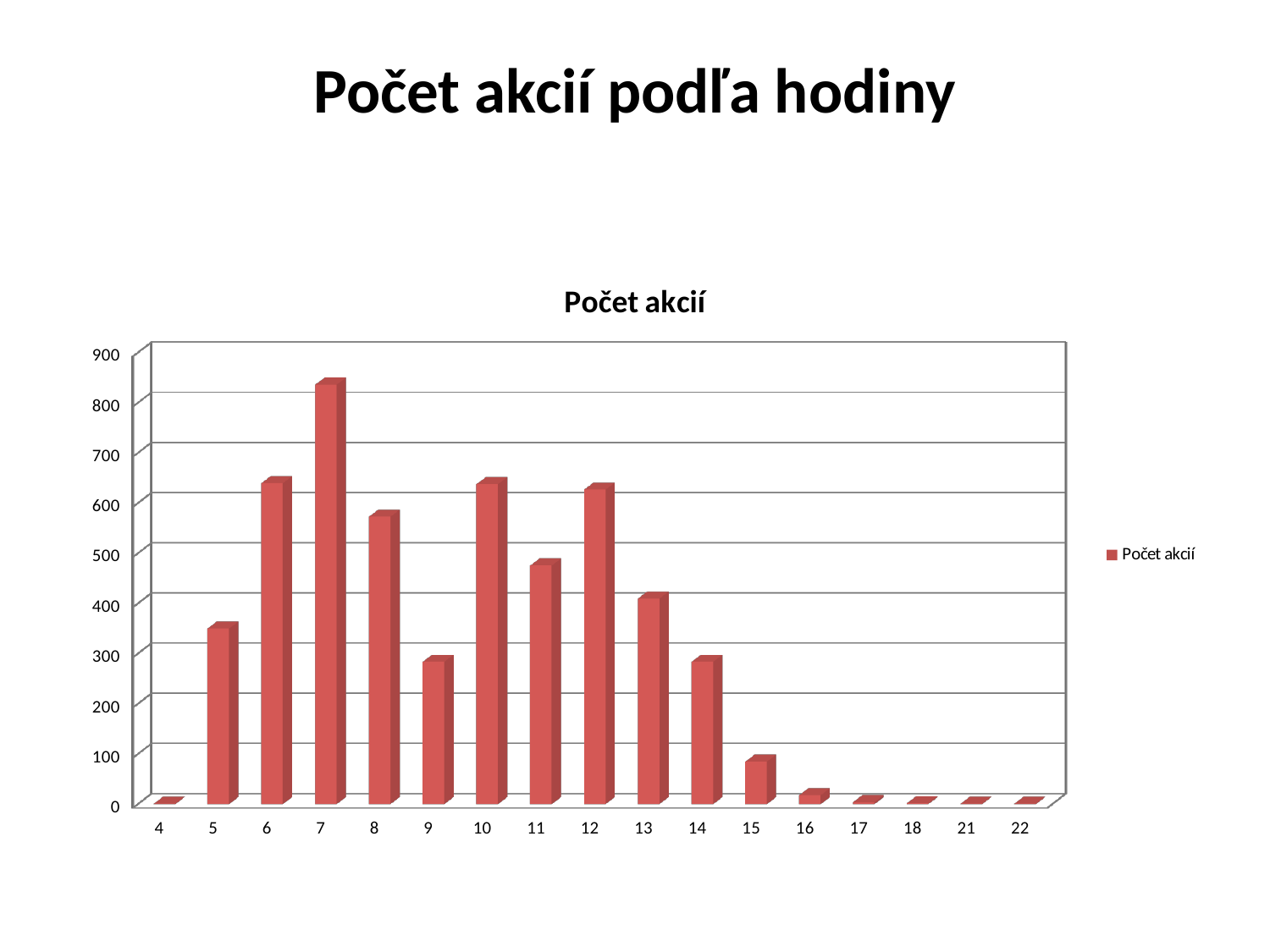
How many hour categories are shown on the x axis? 17 Which hour has the highest number of actions (Počet akcií)? 7 How many series does the legend list? 1 What kind of chart is shown on the slide? bar chart Is the value for hour 11 greater or less than 500? less Is the value for hour 8 greater or less than 500? greater Which is larger, the value for hour 7 or the value for hour 6? hour 7 What is the title of the chart? Počet akcií Is the value for hour 7 greater or less than 800? greater Which is larger, the value for hour 8 or the value for hour 11? hour 8 Do the values rise or fall from hour 12 to hour 17? fall